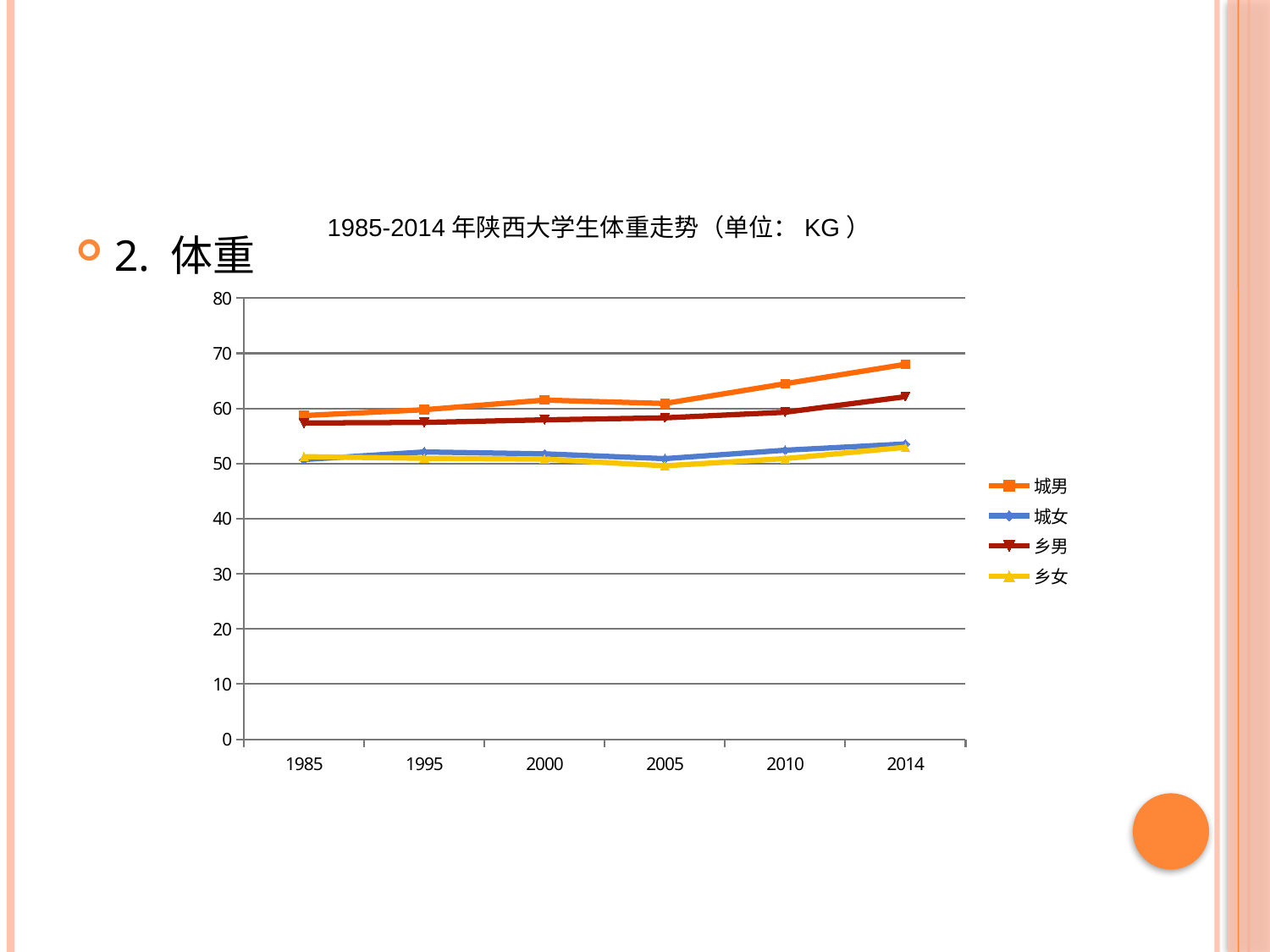
In 2014, which is larger, the value for 城男 or the value for 乡女? 城男 How many years are plotted along the x axis? 6 Is the value for 城男 in 2014 greater or less than 60? greater Is the value for 乡男 in 2014 greater or less than 70? less Does the value for 城男 rise or fall from 2005 to 2014? rise Which series has the highest value in 2014? 城男 Which series is shown in orange with square markers? 城男 How many series does the legend list? 4 Is the value for 城女 in 1985 greater or less than 60? less What is the title of the chart? 1985-2014年陕西大学生体重走势（单位：KG） What kind of chart is shown on the slide? line chart Which series has the lowest value in 2005? 乡女